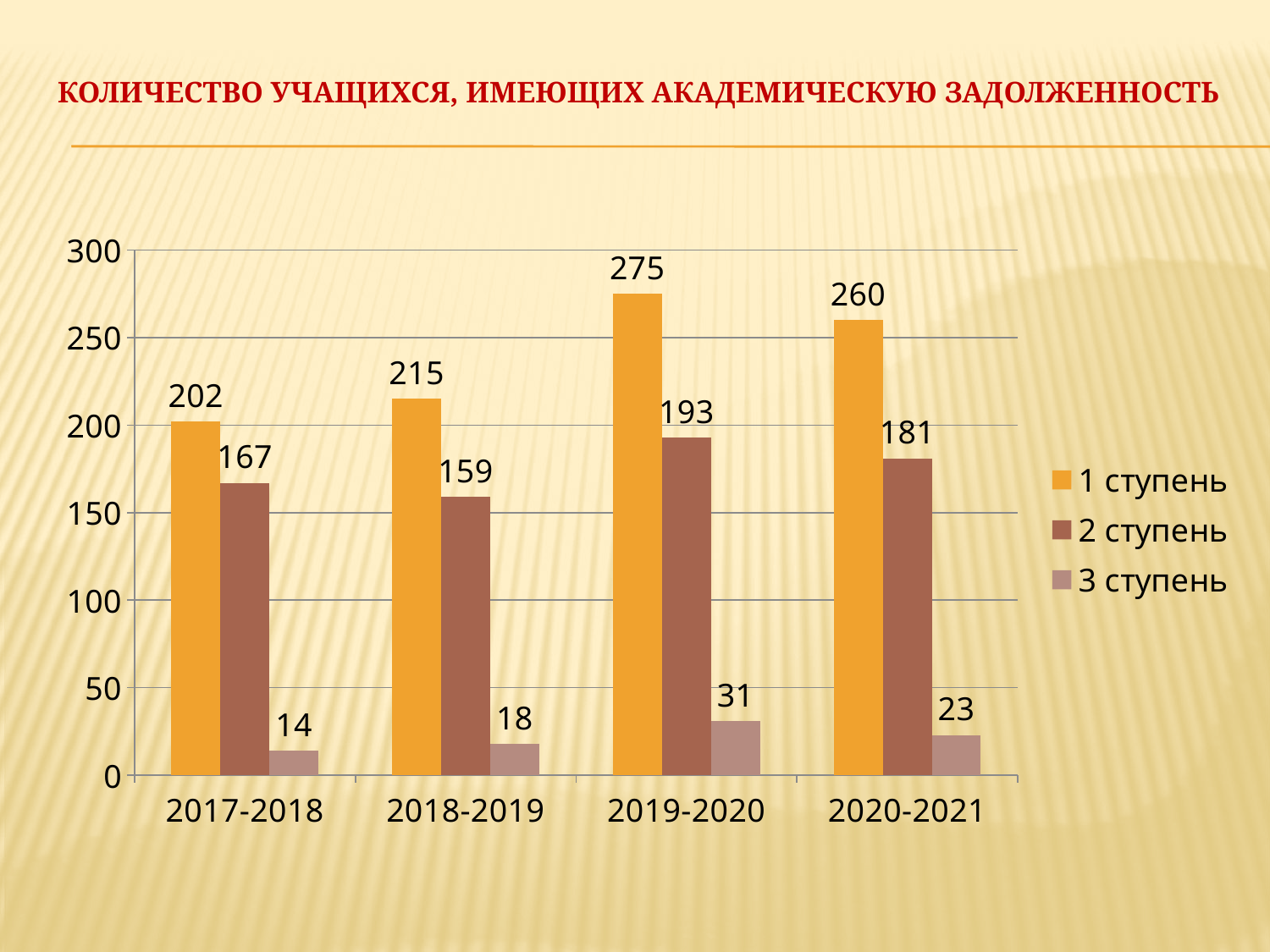
Is the value for 1 ступень in 2018-2019 greater or less than 250? less How many school years are shown on the x axis? 4 What is the value for 3 ступень in 2020-2021? 23 In which year is the value for 3 ступень lowest? 2017-2018 What is the title of the chart? Количество учащихся, имеющих академическую задолженность What kind of chart is shown on the slide? bar chart In which year is the value for 1 ступень highest? 2019-2020 What is the difference between the 1 ступень and 2 ступень values in 2020-2021? 79 Which is larger: 2 ступень in 2017-2018 or 2 ступень in 2018-2019? 2 ступень in 2017-2018 What is the value for 1 ступень in 2019-2020? 275 How many series does the legend list? 3 What is the value for 2 ступень in 2018-2019? 159